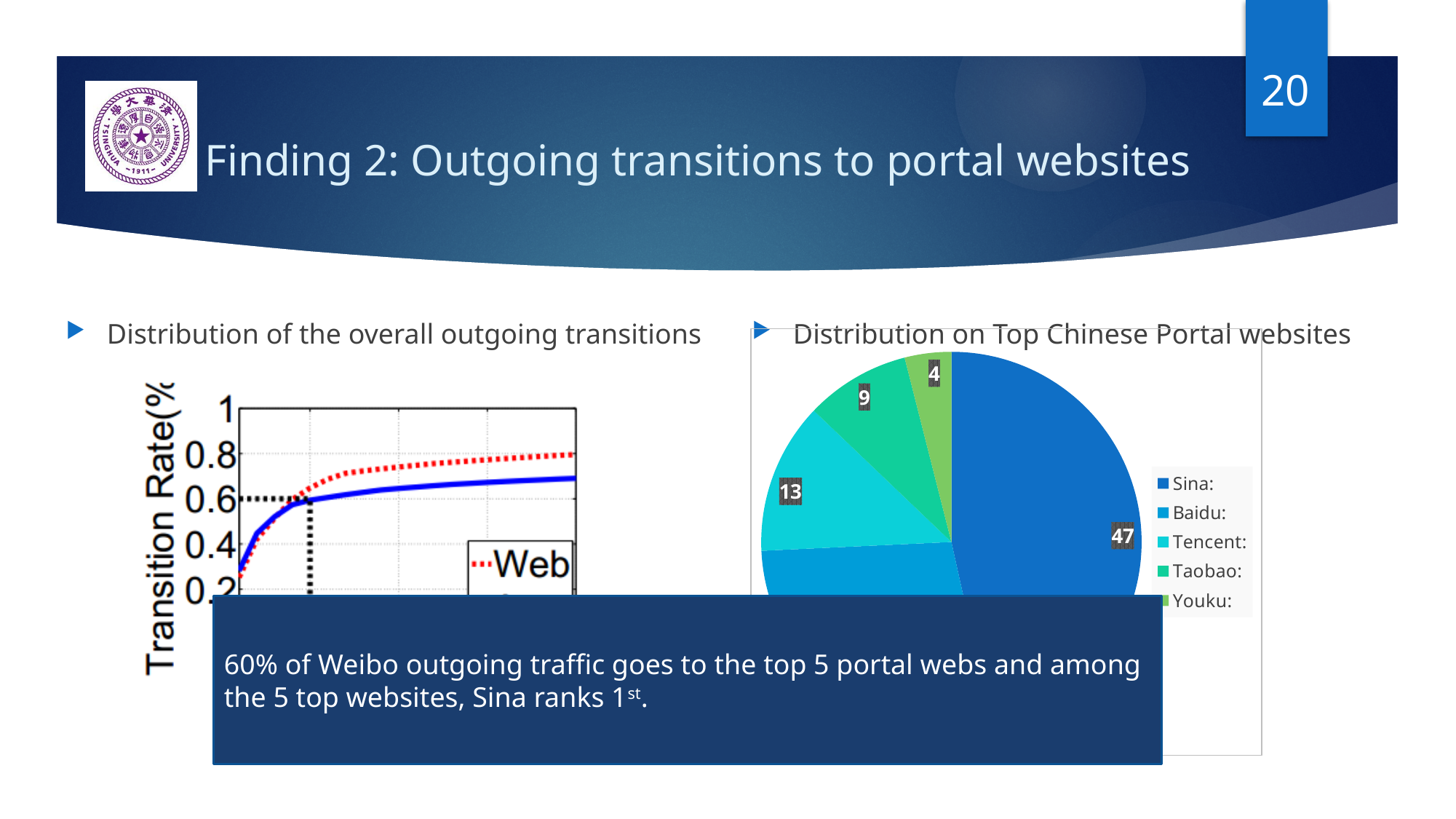
How many entries does the legend of the 'Distribution on Top Chinese Portal websites' chart list? 5 In the 'Distribution on Top Chinese Portal websites' chart, which website has the smallest slice? Youku In the 'Distribution on Top Chinese Portal websites' chart, what is the difference between the values for Sina and Tencent? 34 What kind of chart is the 'Distribution on Top Chinese Portal websites' chart? Pie chart In the 'Distribution on Top Chinese Portal websites' chart, which website has the largest slice? Sina In the 'Distribution on Top Chinese Portal websites' chart, what value is shown for Sina? 47 In the 'Distribution of the overall outgoing transitions' chart on the left, do the plotted lines rise or fall along the x axis? Rise What kind of chart is the 'Distribution of the overall outgoing transitions' chart on the left? Line chart In the 'Distribution on Top Chinese Portal websites' chart, what value is shown for Taobao? 9 In the 'Distribution on Top Chinese Portal websites' chart, what value is shown for Youku? 4 In the 'Distribution on Top Chinese Portal websites' chart, which is larger, the value for Tencent or the value for Taobao? Tencent In the 'Distribution on Top Chinese Portal websites' chart, what value is shown for Tencent? 13